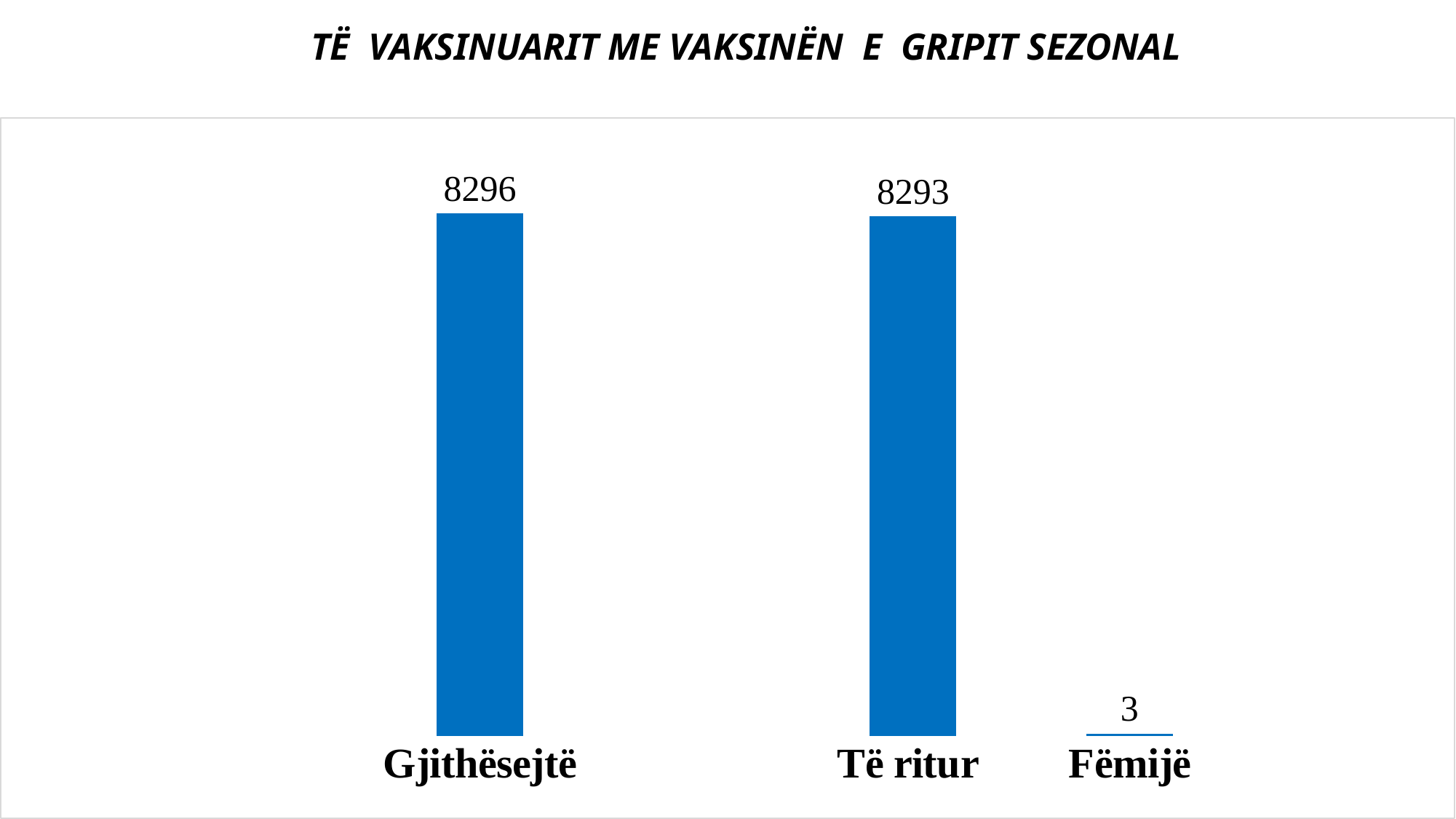
What is the value for Të ritur? 8293 Which is larger, the value for Të ritur or the value for Fëmijë? Të ritur What is the difference between the values for Të ritur and Fëmijë? 8290 What is the value for Gjithësejtë? 8296 What is the title of the chart? TË VAKSINUARIT ME VAKSINËN E GRIPIT SEZONAL How many categories are shown in the chart? 3 What colour are the bars in the chart? Blue What is the value for Fëmijë? 3 What kind of chart is shown on the slide? Bar chart Which category has the lowest value? Fëmijë What is the difference between the values for Gjithësejtë and Të ritur? 3